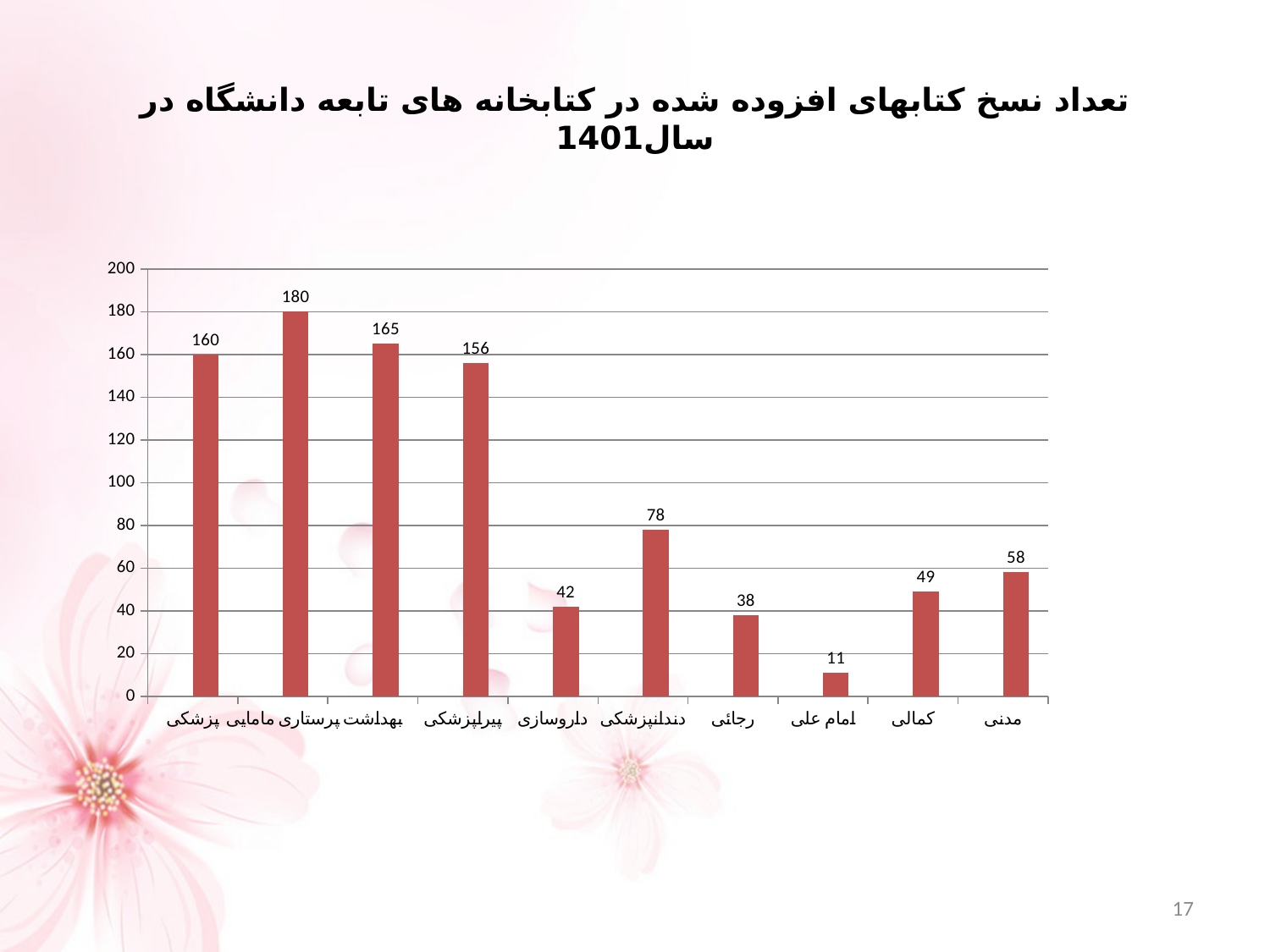
What is the difference between the values for پرستاری مامایی and رجائی? 142 What is the value for پزشکی? 160 What year is mentioned in the chart title? 1401 What is the difference between the values for بهداشت and پیراپزشکی? 9 Is the value for داروسازی greater or less than 60? less How many categories (libraries) are shown on the x axis? 10 Which is larger, the value for کمالی or the value for مدنی? مدنی What is the value for امام علی? 11 Which category has the lowest value? امام علی Which category has the highest value? پرستاری مامایی What is the value for دندانپزشکی? 78 What type of chart is shown on the slide? bar chart